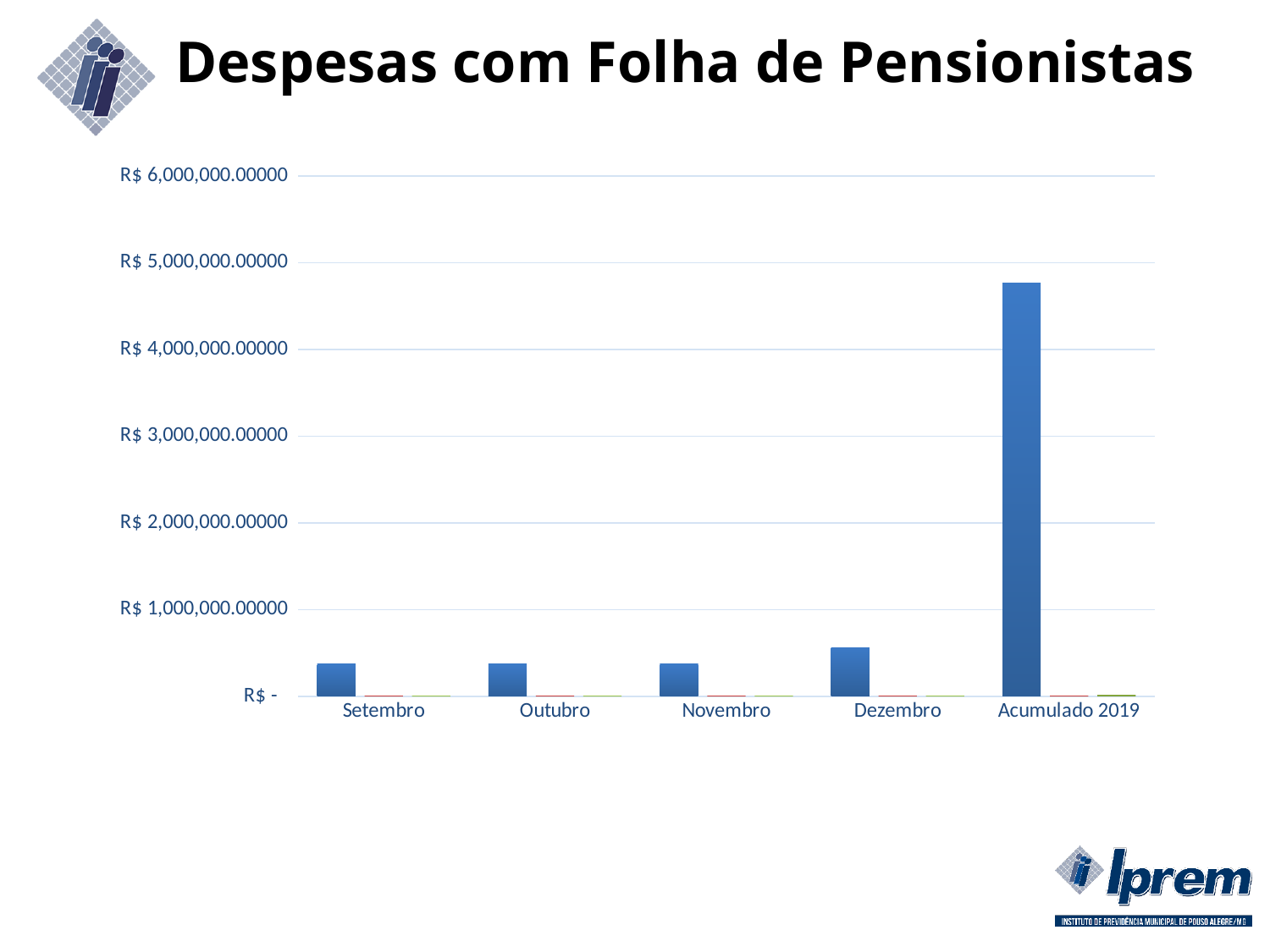
What type of chart is shown on the slide? bar chart Which category has the highest blue bar? Acumulado 2019 Which has the larger blue bar, Dezembro or Novembro? Dezembro Which category is the last one on the x axis of the chart? Acumulado 2019 What is the highest value labelled on the vertical axis of the chart? R$ 6,000,000.00000 How many categories are shown on the x axis of the chart? 5 Which has the larger blue bar, Acumulado 2019 or Dezembro? Acumulado 2019 Is the blue bar value for Acumulado 2019 greater or less than R$ 5,000,000? less Is the blue bar value for Acumulado 2019 greater or less than R$ 4,000,000? greater What is the title of the chart? Despesas com Folha de Pensionistas Is the blue bar value for Dezembro greater or less than R$ 1,000,000? less